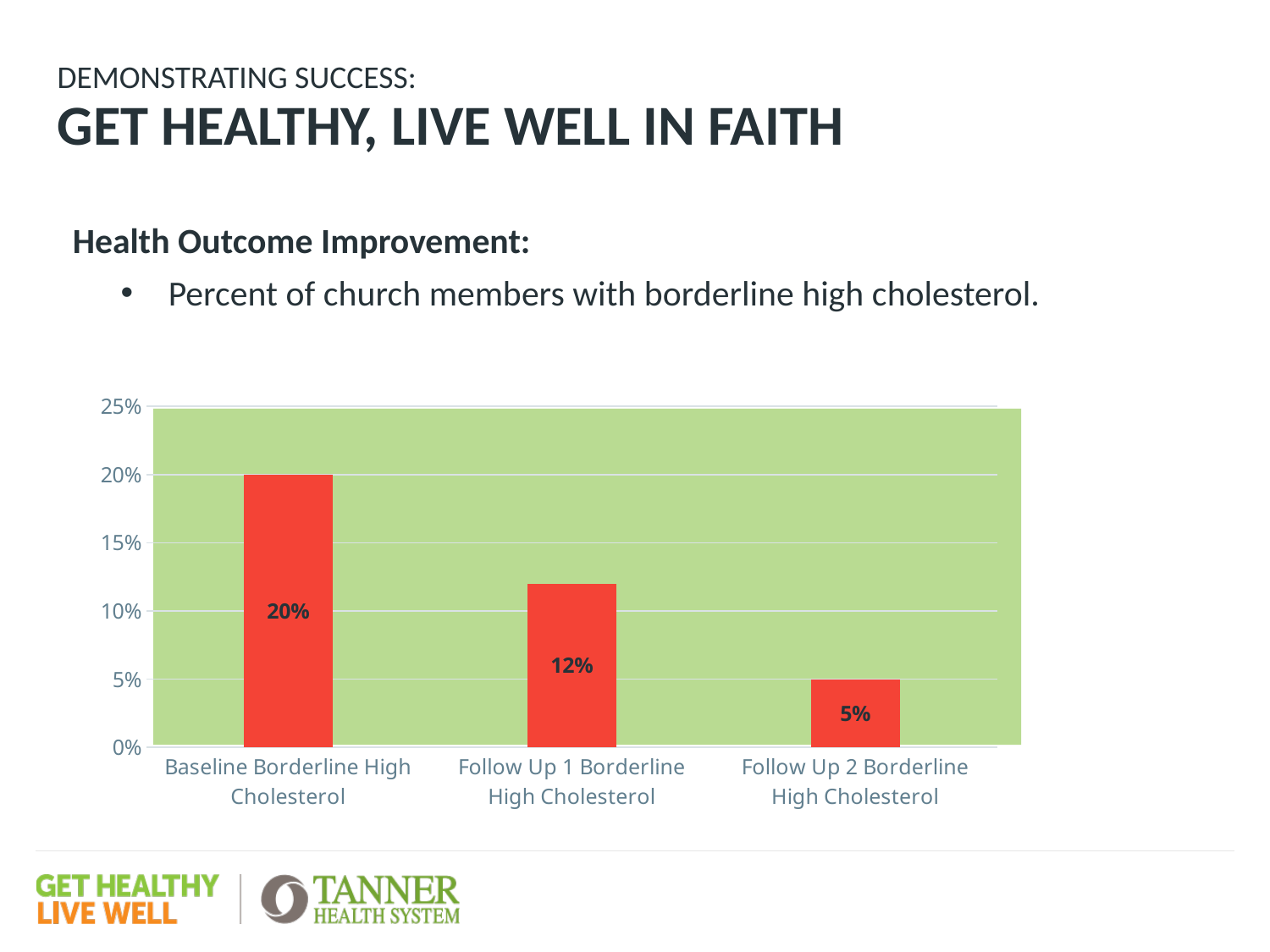
What is the value for Follow Up 2 Borderline High Cholesterol? 5% Do the values rise or fall from Baseline to Follow Up 2? fall Is the value for Follow Up 1 Borderline High Cholesterol greater or less than 15%? less What is the difference between the Baseline Borderline High Cholesterol value and the Follow Up 2 Borderline High Cholesterol value? 15% What is the value for Baseline Borderline High Cholesterol? 20% What is the difference between the Baseline Borderline High Cholesterol value and the Follow Up 1 Borderline High Cholesterol value? 8% Which category has the highest value? Baseline Borderline High Cholesterol What kind of chart is shown on the slide? bar chart Which category has the lowest value? Follow Up 2 Borderline High Cholesterol Which is larger, the value for Follow Up 1 Borderline High Cholesterol or the value for Follow Up 2 Borderline High Cholesterol? Follow Up 1 Borderline High Cholesterol What is the value for Follow Up 1 Borderline High Cholesterol? 12% How many categories are shown in the chart? 3